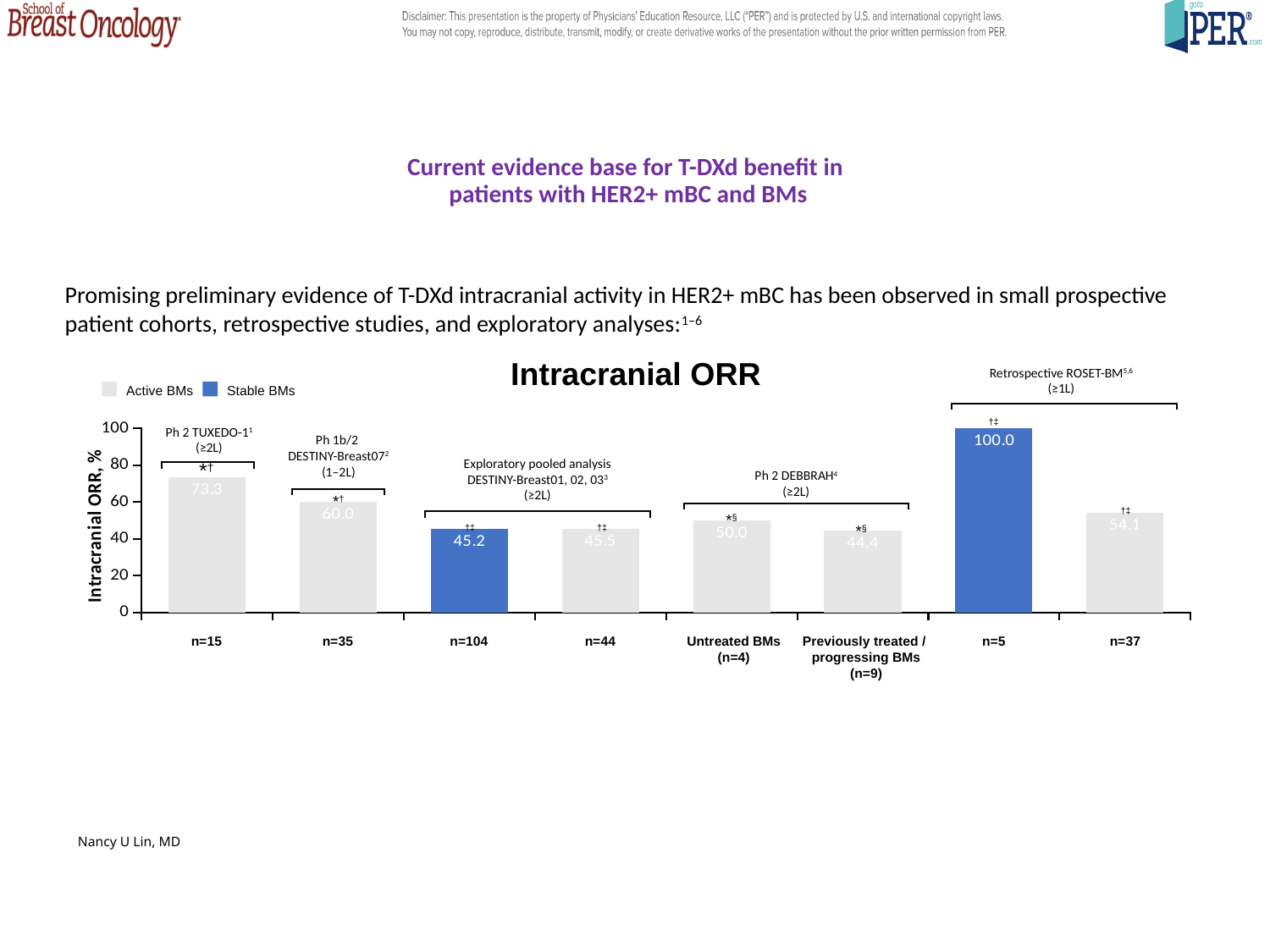
What is the intracranial ORR for the n=15 group (Ph 2 TUXEDO-1)? 73.3 What is the difference in intracranial ORR between the n=15 group and the n=35 group? 13.3 Which group has the lowest intracranial ORR? Previously treated / progressing BMs (n=9) What is the intracranial ORR for the Previously treated / progressing BMs (n=9) group in Ph 2 DEBBRAH? 44.4 How many bars are plotted in the Intracranial ORR chart? 8 Which colour represents Stable BMs in the legend? Blue What is the intracranial ORR for the n=104 group in the exploratory pooled analysis? 45.2 Which group has the highest intracranial ORR? n=5 (Retrospective ROSET-BM) What is the intracranial ORR for the n=35 group (Ph 1b/2 DESTINY-Breast07)? 60.0 Which has a higher intracranial ORR: the Untreated BMs (n=4) group or the n=37 group? n=37 What type of chart is used to show Intracranial ORR? Bar chart How many series does the legend list? 2